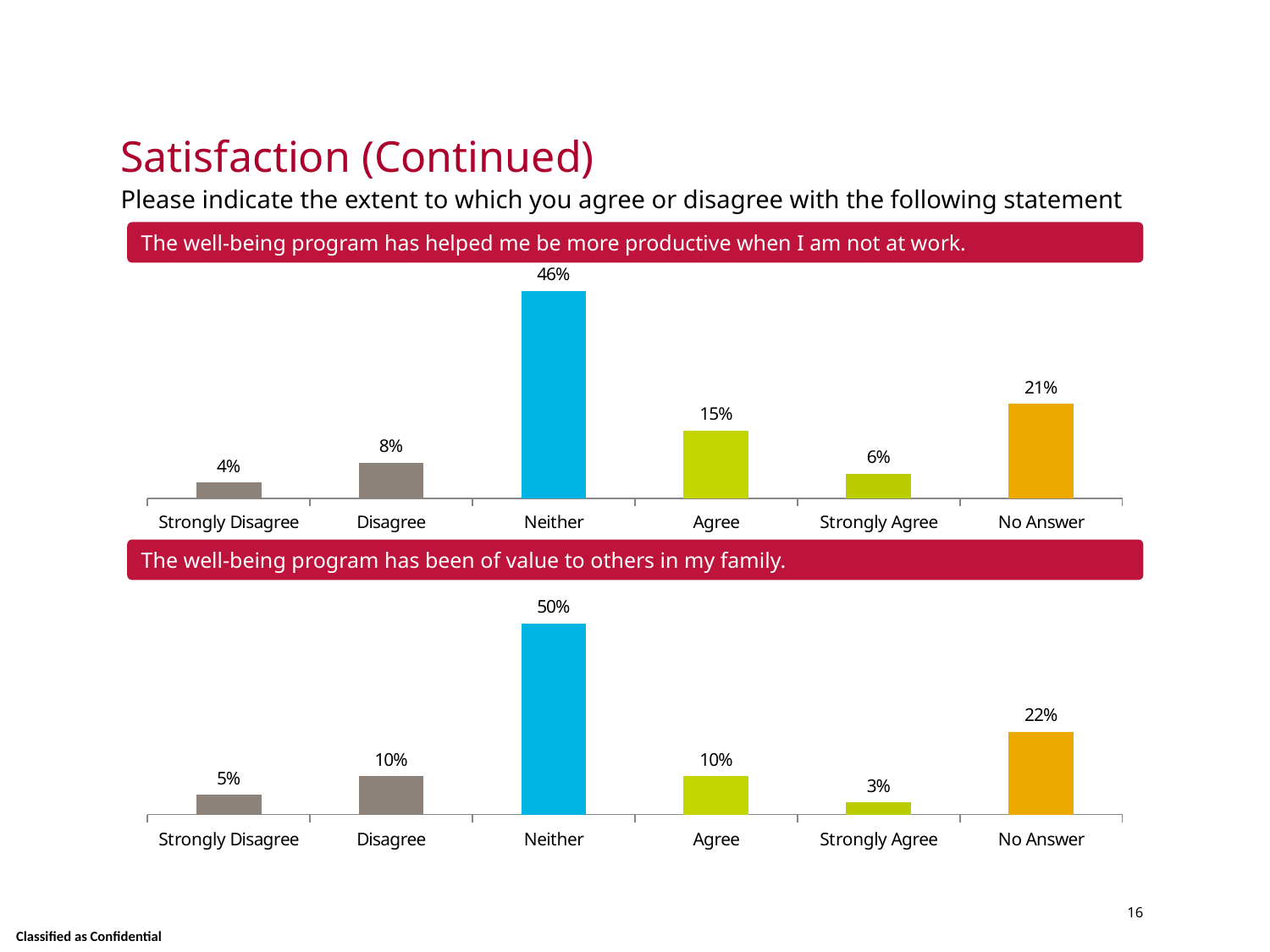
In the top chart ('The well-being program has helped me be more productive when I am not at work.'), what percentage chose Strongly Agree? 6% In the bottom chart ('The well-being program has been of value to others in my family.'), what percentage chose Strongly Disagree? 5% What colour is the Neither bar in the top chart ('The well-being program has helped me be more productive when I am not at work.')? Blue In the top chart ('The well-being program has helped me be more productive when I am not at work.'), what is the difference between the Agree and Disagree values? 7% What type of chart is the top chart ('The well-being program has helped me be more productive when I am not at work.')? Bar chart How many categories are shown on the x axis of the bottom chart ('The well-being program has been of value to others in my family.')? 6 In the top chart ('The well-being program has helped me be more productive when I am not at work.'), what percentage of respondents chose Neither? 46% In the bottom chart ('The well-being program has been of value to others in my family.'), what is the combined value of Agree and Strongly Agree? 13% In the bottom chart ('The well-being program has been of value to others in my family.'), what percentage chose No Answer? 22% In the top chart ('The well-being program has helped me be more productive when I am not at work.'), which category has the highest value? Neither In the bottom chart ('The well-being program has been of value to others in my family.'), which is larger: Agree or Strongly Agree? Agree In the bottom chart ('The well-being program has been of value to others in my family.'), which category has the lowest value? Strongly Agree